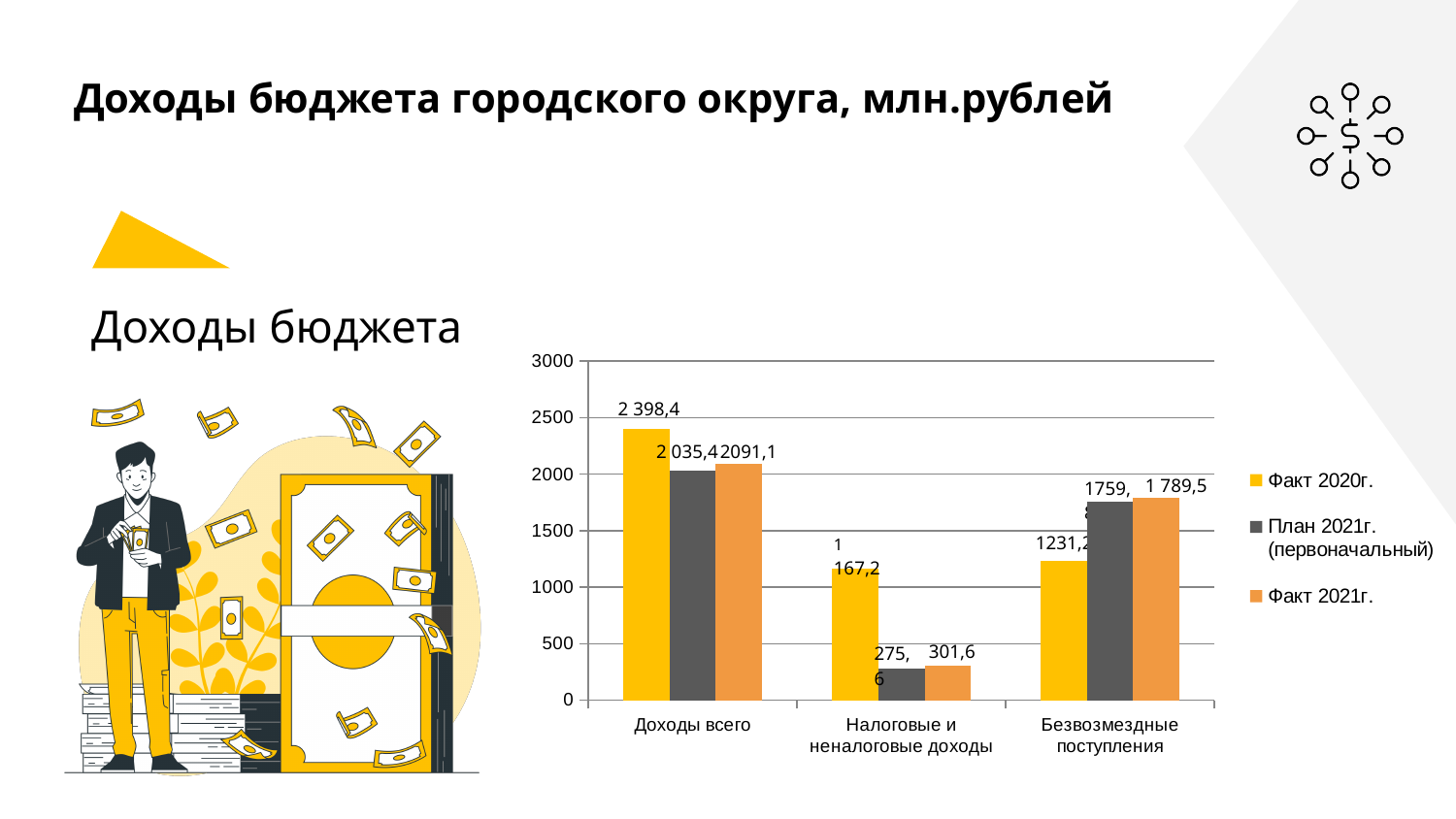
What is the value of План 2021г. (первоначальный) for Доходы всего? 2 035,4 Is the value of Факт 2020г. for Безвозмездные поступления greater or less than 1500? less Which series has the lowest value for Налоговые и неналоговые доходы? План 2021г. (первоначальный) What is the value of Факт 2020г. for Доходы всего? 2 398,4 Which series has the highest value for Доходы всего? Факт 2020г. What is the difference between Факт 2020г. and Факт 2021г. for Доходы всего? 307,3 How many series does the legend list? 3 What is the value of Факт 2021г. for Доходы всего? 2091,1 What is the value of Факт 2021г. for Безвозмездные поступления? 1 789,5 What kind of chart is shown on the slide? bar chart How many categories are shown on the x axis? 3 What is the value of Факт 2021г. for Налоговые и неналоговые доходы? 301,6